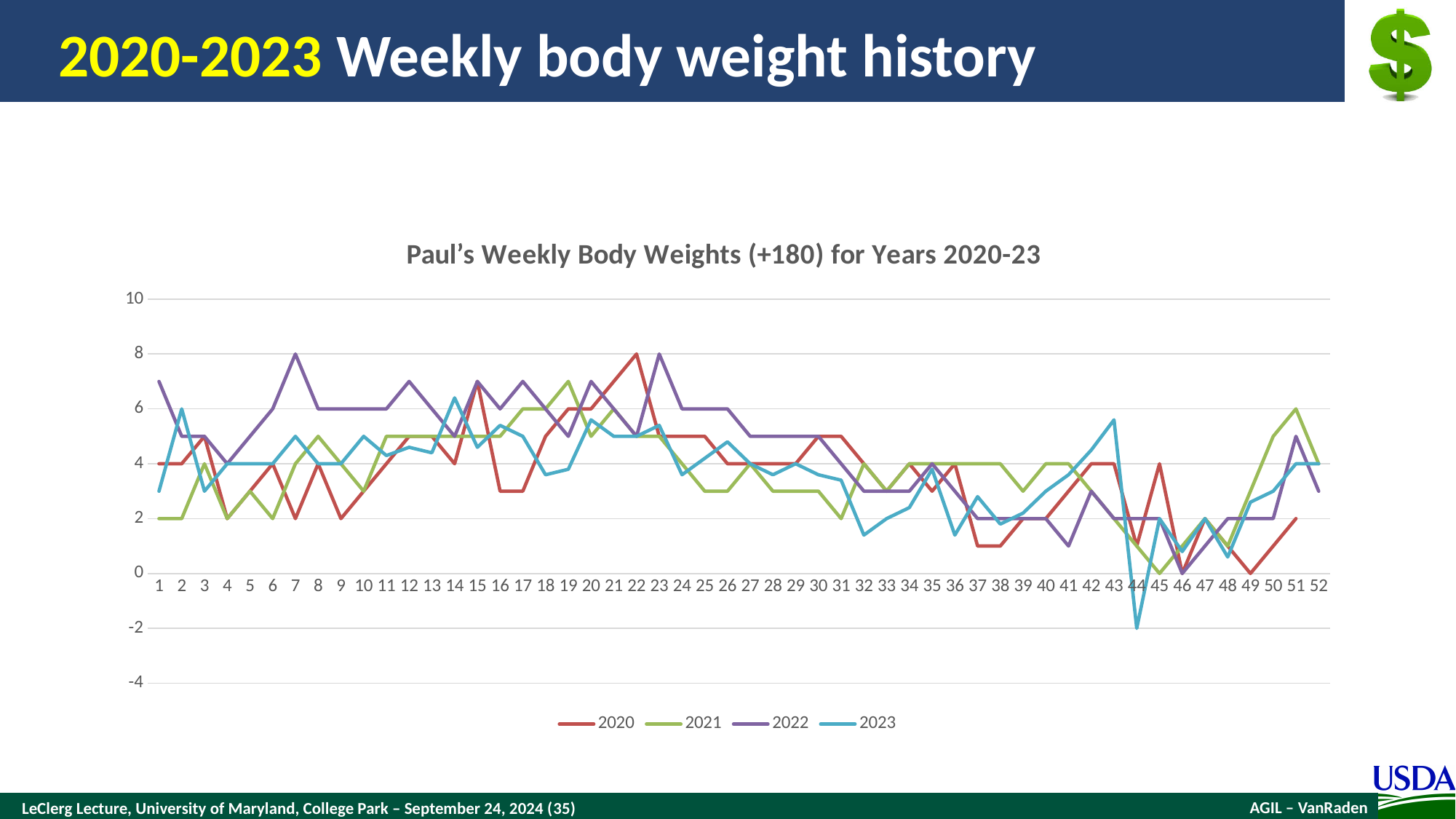
What is the title of the chart? Paul's Weekly Body Weights (+180) for Years 2020-23 What is the value for 2022 at week 7? 8 Which years are listed in the legend? 2020, 2021, 2022, 2023 How many weeks are plotted along the x axis? 52 What is the value for 2023 at week 44? -2 Which series has the lowest value at week 44? 2023 What is the value for 2020 at week 22? 8 Is the value for 2022 at week 7 greater or less than 6? greater Which series has the highest value at week 7? 2022 Is the value for 2023 at week 44 greater or less than 0? less How many series does the legend list? 4 What kind of chart is shown on the slide? line chart